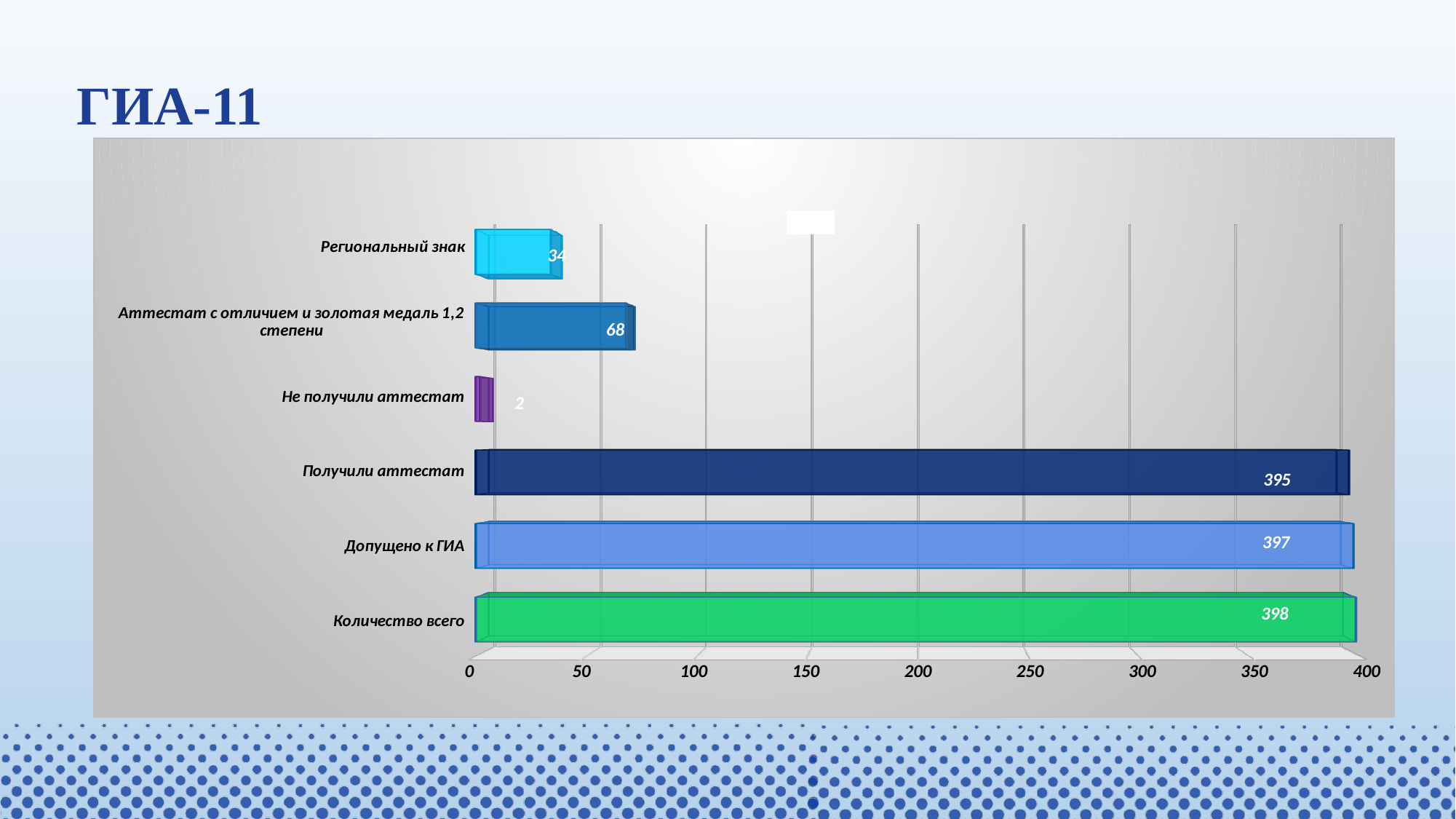
What is the value for "Региональный знак"? 34 What is the value for "Аттестат с отличием и золотая медаль 1,2 степени"? 68 Which is larger, "Аттестат с отличием и золотая медаль 1,2 степени" or "Региональный знак"? Аттестат с отличием и золотая медаль 1,2 степени How many categories are shown in the chart? 6 What is the value for "Получили аттестат"? 395 What kind of chart is shown on the slide? Bar chart What is the value for "Допущено к ГИА"? 397 What is the value for "Не получили аттестат"? 2 What is the value for "Количество всего"? 398 What is the difference between "Допущено к ГИА" and "Получили аттестат"? 2 Which category has the lowest value? Не получили аттестат Which category has the highest value? Количество всего